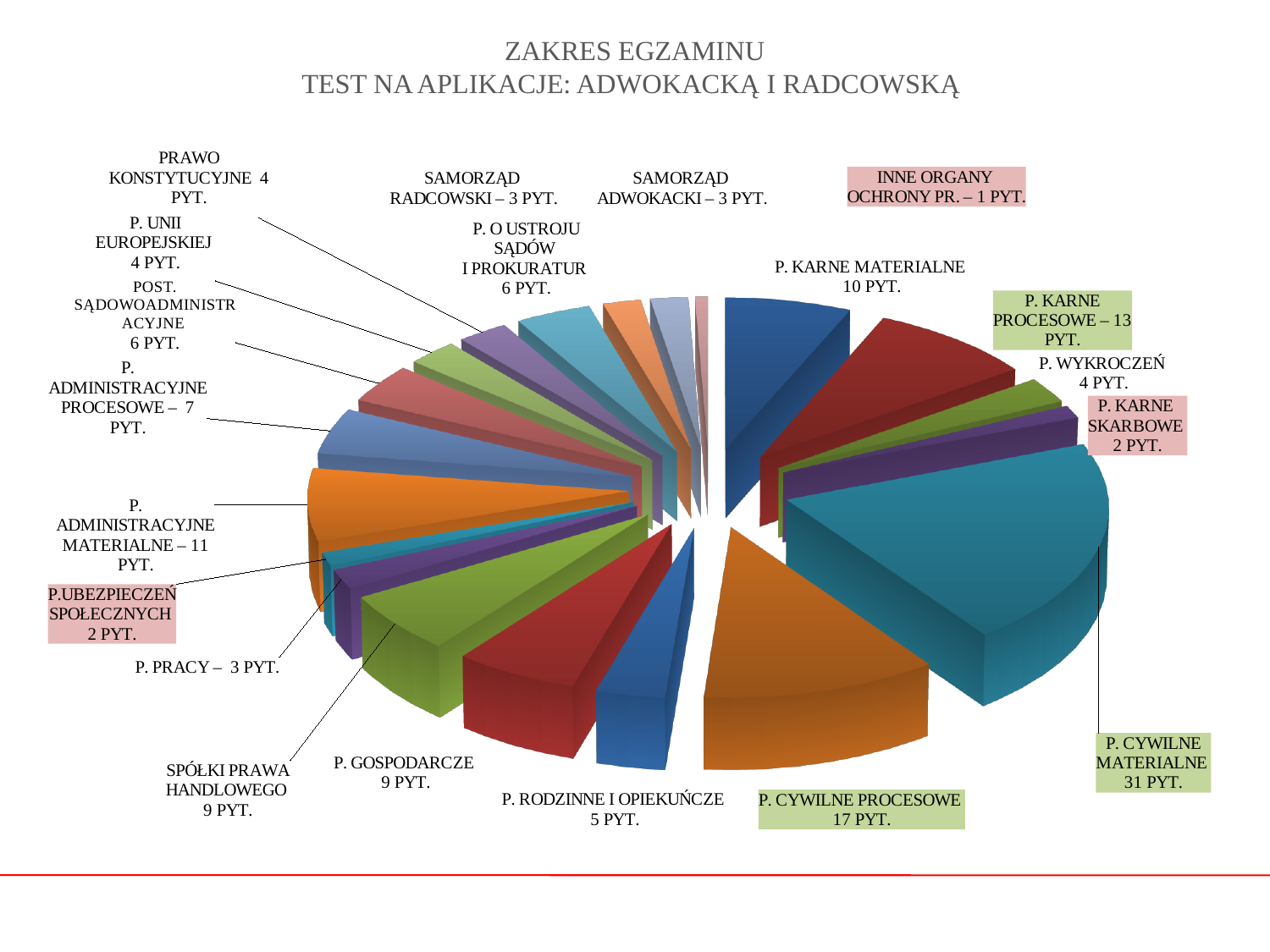
What is the title of the slide containing the chart? ZAKRES EGZAMINU TEST NA APLIKACJE: ADWOKACKĄ I RADCOWSKĄ What is the difference in questions between P. CYWILNE MATERIALNE and P. CYWILNE PROCESOWE? 14 How many questions (PYT.) are allocated to P. CYWILNE MATERIALNE? 31 PYT. Which has more questions, P. KARNE MATERIALNE or P. KARNE PROCESOWE? P. KARNE PROCESOWE Which has more questions, P. GOSPODARCZE or P. RODZINNE I OPIEKUŃCZE? P. GOSPODARCZE How many questions are allocated to P. ADMINISTRACYJNE MATERIALNE? 11 PYT. How many questions are allocated to SAMORZĄD RADCOWSKI? 3 PYT. What kind of chart is shown on the slide? pie chart Which category has the largest number of questions? P. CYWILNE MATERIALNE Which category has the smallest number of questions? INNE ORGANY OCHRONY PR. How many questions are allocated to P. KARNE PROCESOWE? 13 PYT. How many categories (slices) does the pie chart have? 20